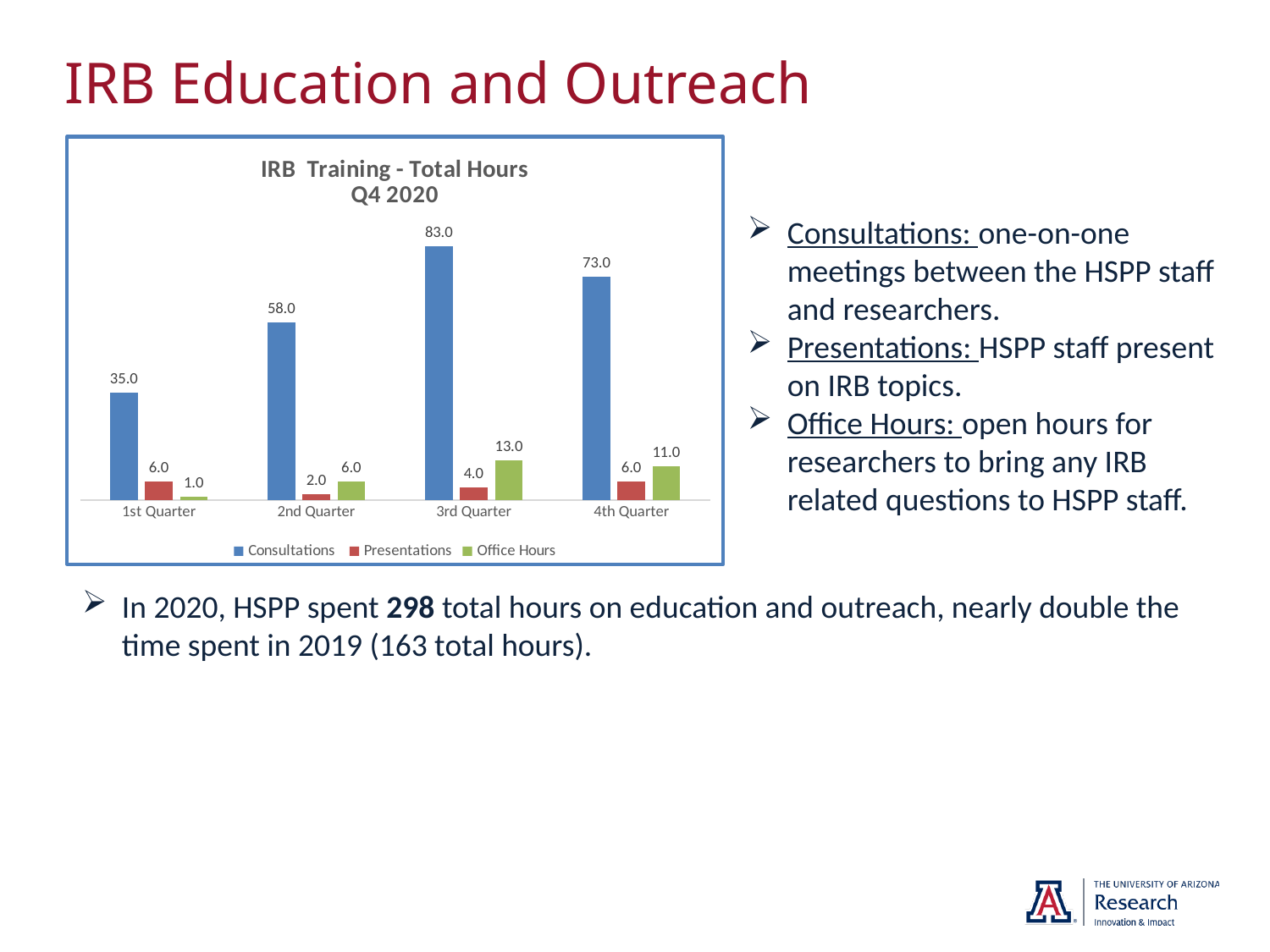
What is the value for Office Hours in the 1st Quarter? 1.0 What kind of chart is shown? Bar chart How many quarters are shown on the x axis? 4 Do the Consultations values rise or fall from the 1st Quarter to the 3rd Quarter? Rise What is the value for Presentations in the 2nd Quarter? 2.0 In which quarter is the Office Hours value lowest? 1st Quarter What is the difference between Consultations in the 3rd Quarter and the 4th Quarter? 10.0 Which is larger: Office Hours in the 3rd Quarter or Office Hours in the 4th Quarter? Office Hours in the 3rd Quarter What is the title of the chart? IRB Training - Total Hours Q4 2020 How many series does the legend list? 3 What is the value for Consultations in the 3rd Quarter? 83.0 In which quarter is the Consultations value highest? 3rd Quarter